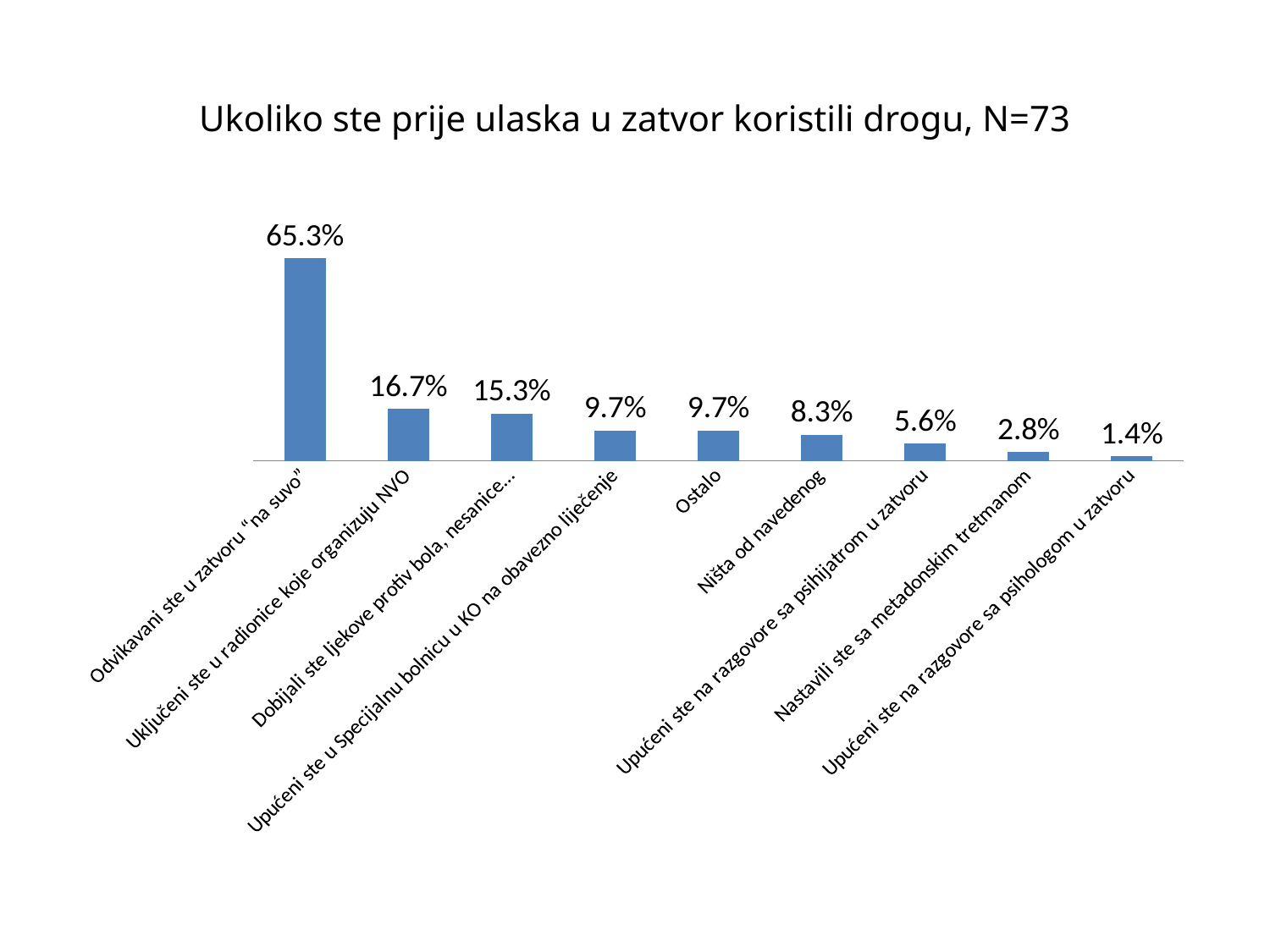
What is the title of the chart? Ukoliko ste prije ulaska u zatvor koristili drogu, N=73 Do the values rise or fall from left to right along the x axis? Fall What kind of chart is shown on the slide? Bar chart Which is larger, the value for "Ništa od navedenog" or the value for "Upućeni ste na razgovore sa psihijatrom u zatvoru"? Ništa od navedenog Which category has the lowest value? Upućeni ste na razgovore sa psihologom u zatvoru What is the value for "Odvikavani ste u zatvoru “na suvo”"? 65.3% What is the value for "Uključeni ste u radionice koje organizuju NVO"? 16.7% What is the difference between the values for "Uključeni ste u radionice koje organizuju NVO" and "Ništa od navedenog"? 8.4% What is the value for "Ostalo"? 9.7% How many categories are shown in the chart? 9 What is the value for "Nastavili ste sa metadonskim tretmanom"? 2.8% Which category has the highest value? Odvikavani ste u zatvoru “na suvo”